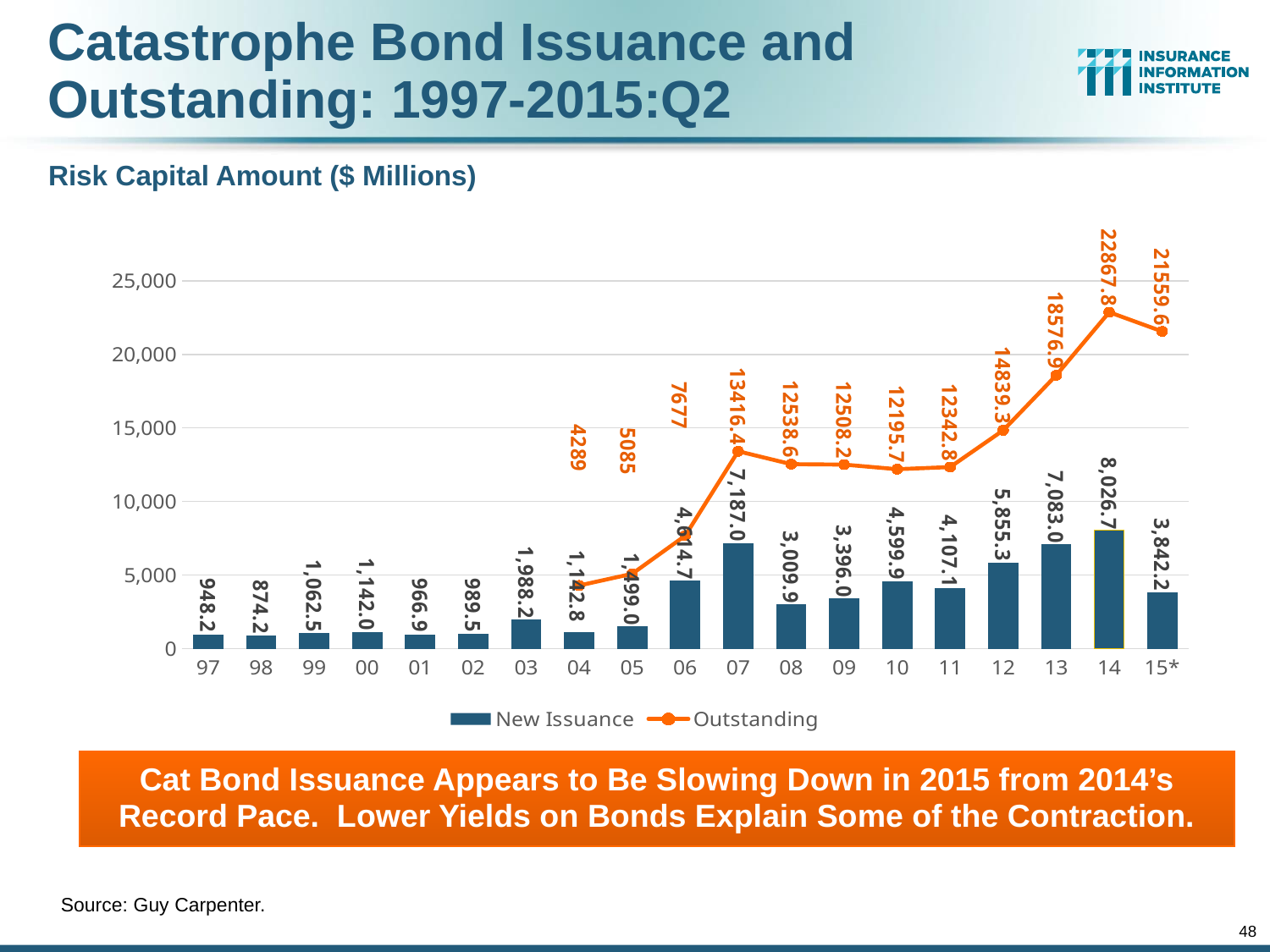
What kind of chart is this? Combined bar and line chart How many years are shown on the x axis? 19 What is the difference between the New Issuance values for 14 and 15*? 4,184.5 What is the New Issuance value for 14? 8,026.7 What is the New Issuance value for 07? 7,187.0 Does the Outstanding line rise or fall from 12 to 14? rise Which year has the lowest New Issuance value? 98 Which year has the highest New Issuance value? 14 How many series does the legend list? 2 Which year has the larger Outstanding value, 12 or 13? 13 Is the Outstanding value for 07 greater or less than 10,000? greater What is the Outstanding value for 14? 22867.8